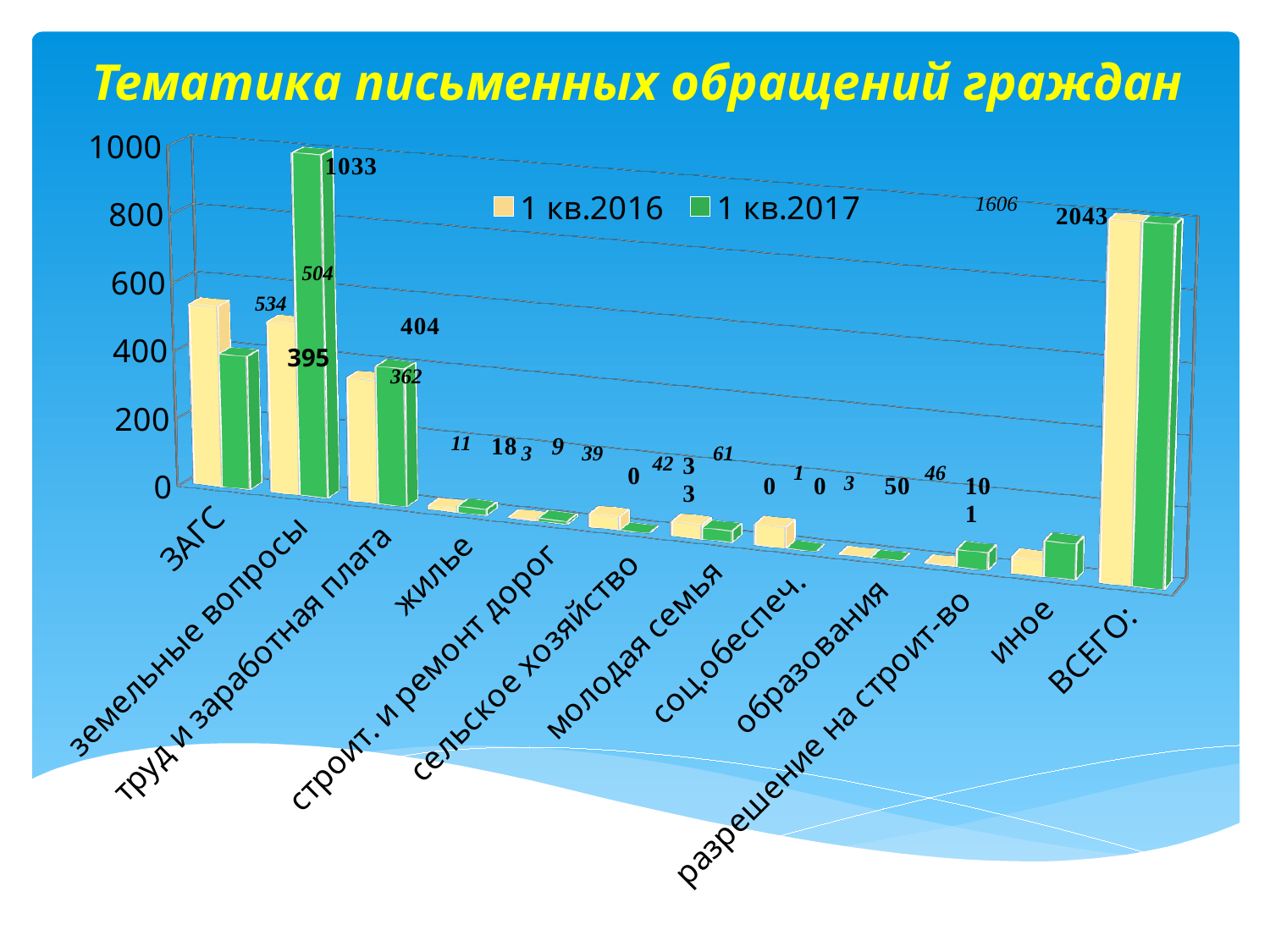
What is the 1 кв.2017 value for труд и заработная плата? 404 What is the 1 кв.2016 value for ВСЕГО:? 1606 How many series does the legend list? 2 For ЗАГС, which series has the larger value, 1 кв.2016 or 1 кв.2017? 1 кв.2016 What is the difference between the 1 кв.2017 and 1 кв.2016 values for земельные вопросы? 529 How many categories are shown along the x axis? 12 What is the 1 кв.2016 value for ЗАГС? 534 What kind of chart is shown on the slide? bar chart What is the difference between the 1 кв.2017 and 1 кв.2016 values for ВСЕГО:? 437 What is the 1 кв.2017 value for ВСЕГО:? 2043 What is the 1 кв.2017 value for земельные вопросы? 1033 What is the title of the chart? Тематика письменных обращений граждан